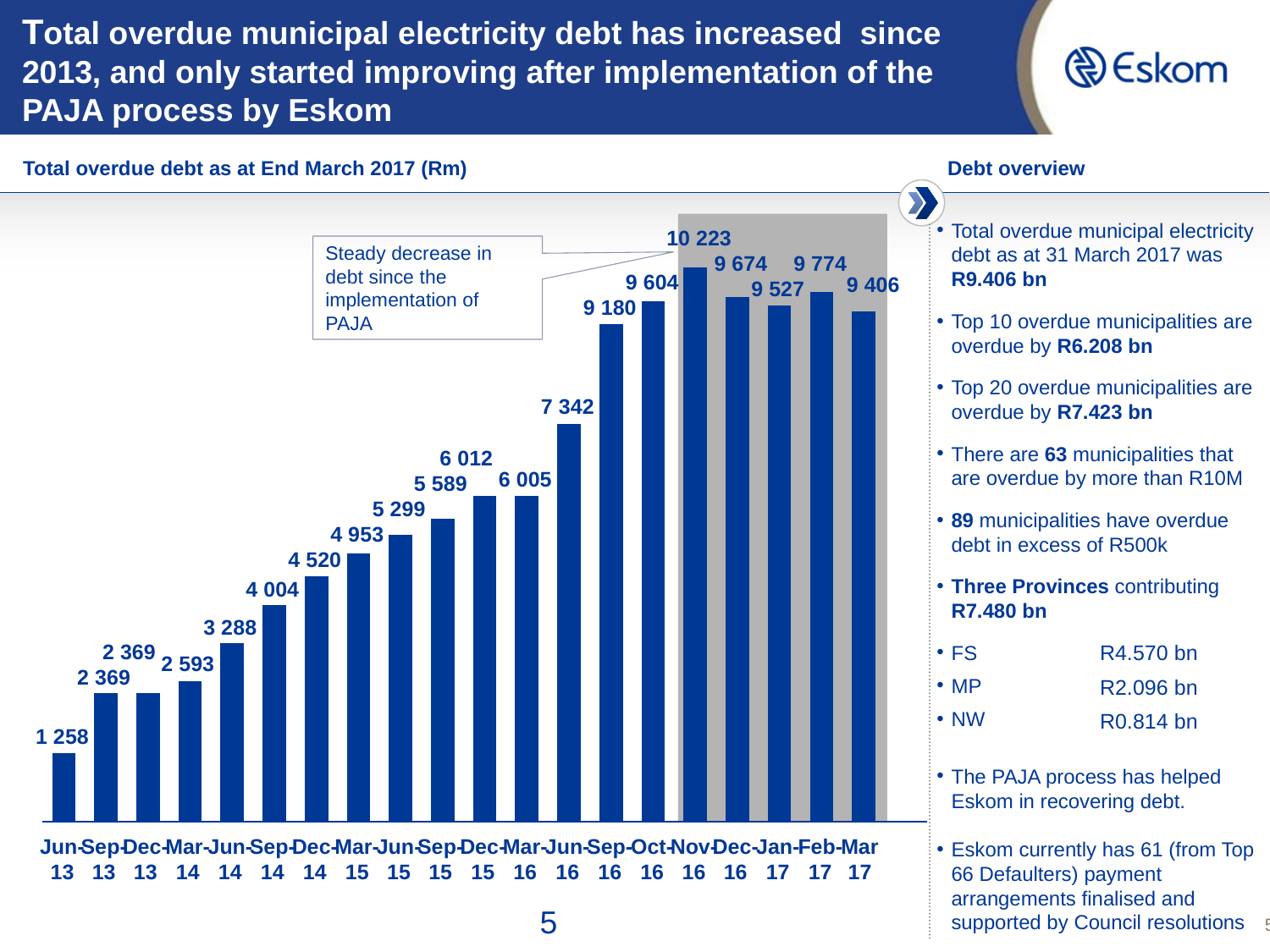
Which is larger, the overdue debt in Sep-16 or in Feb-17? Feb-17 What is the difference between the overdue debt in Nov-16 and Mar-17? 817 Which period has the lowest total overdue debt? Jun-13 What is the difference between the overdue debt in Mar-17 and Jun-13? 8 148 How many periods are shown on the chart? 20 What kind of chart is used to show total overdue debt? Bar chart Which period has the highest total overdue debt? Nov-16 What is the total overdue debt value for Jun-16? 7 342 What is the title of the chart? Total overdue debt as at End March 2017 (Rm) What is the total overdue debt value for Mar-17? 9 406 What is the total overdue debt value for Nov-16? 10 223 What is the total overdue debt value for Jun-13? 1 258